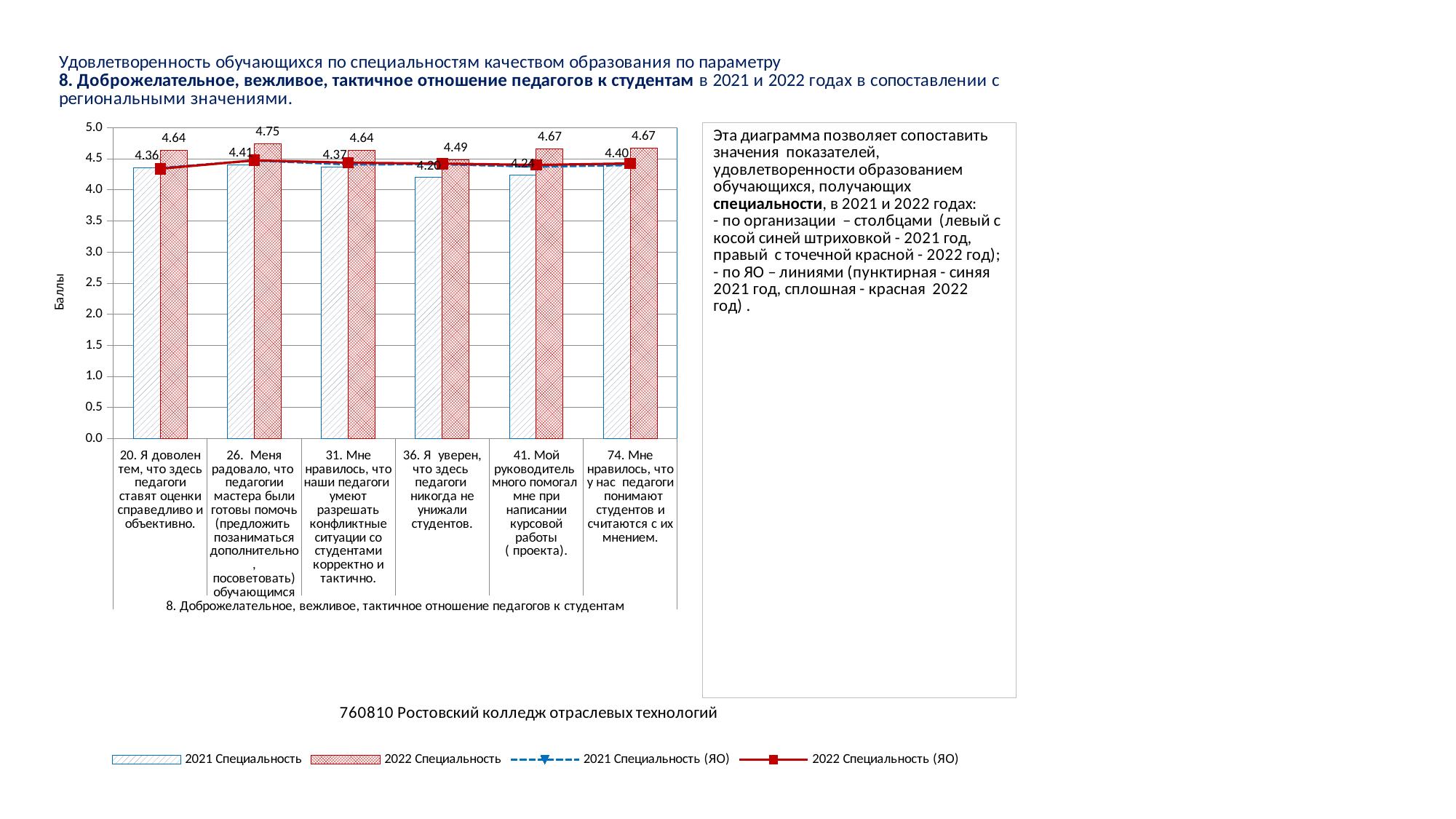
How many series does the chart legend list? 4 What is the value of the 2022 Специальность bar for question 36 (Я уверен, что здесь педагоги никогда не унижали студентов)? 4.49 What kind of chart is shown on the slide? Combined bar and line chart Which category has the highest 2022 Специальность bar? 26. Меня радовало, что педагогии мастера были готовы помочь What is the label of the y axis of the chart? Баллы What is the value of the 2022 Специальность bar for question 26 (Меня радовало, что педагогии мастера были готовы помочь)? 4.75 What is the difference between the 2022 and 2021 Специальность values for question 41 (Мой руководитель много помогал мне при написании курсовой работы)? 0.43 Is the 2021 Специальность value for question 36 greater or less than 4.5? less How many categories (questions) are shown on the x axis of the chart? 6 What is the value of the 2021 Специальность bar for question 20 (Я доволен тем, что здесь педагоги ставят оценки справедливо и объективно)? 4.36 For question 74, which is larger: the 2021 Специальность bar or the 2022 Специальность bar? 2022 Специальность Which category has the lowest 2021 Специальность bar? 36. Я уверен, что здесь педагоги никогда не унижали студентов